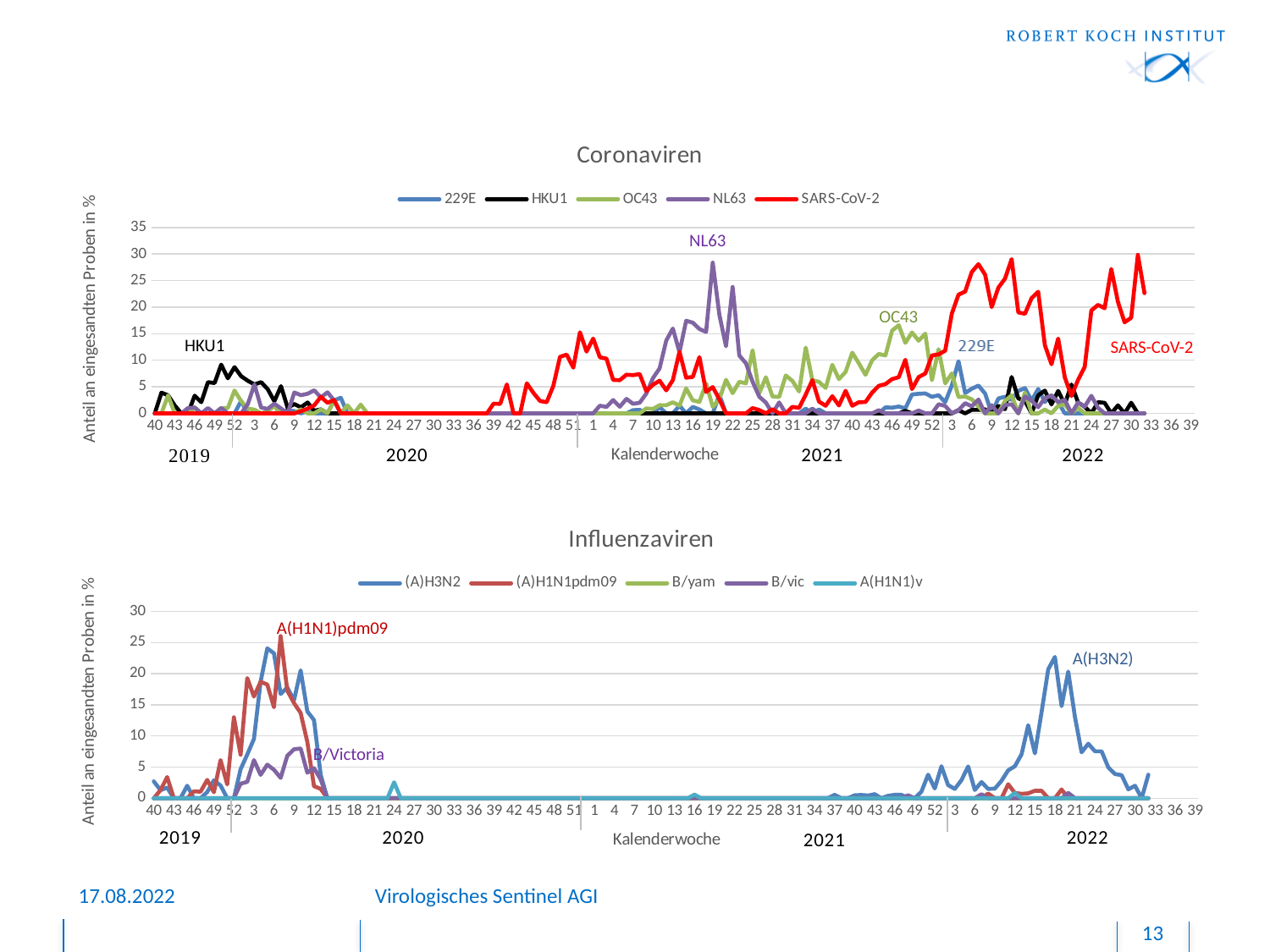
How many series does the legend of the Coronaviren chart list? 5 In the Coronaviren chart, is the peak value of NL63 greater or less than 25? greater In the Influenzaviren chart, is the peak value of B/Victoria greater or less than 10? less In the Coronaviren chart, is the highest value of SARS-CoV-2 greater or less than 25? greater What is the x-axis label of the Influenzaviren chart? Kalenderwoche In the Influenzaviren chart, which series reaches a higher peak, A(H1N1)pdm09 or B/Victoria? A(H1N1)pdm09 What kind of chart is the Coronaviren chart? line chart In the Coronaviren chart, which series reaches a higher peak, SARS-CoV-2 or HKU1? SARS-CoV-2 How many series does the legend of the Influenzaviren chart list? 5 What is the y-axis label of the Coronaviren chart? Anteil an eingesandten Proben in %